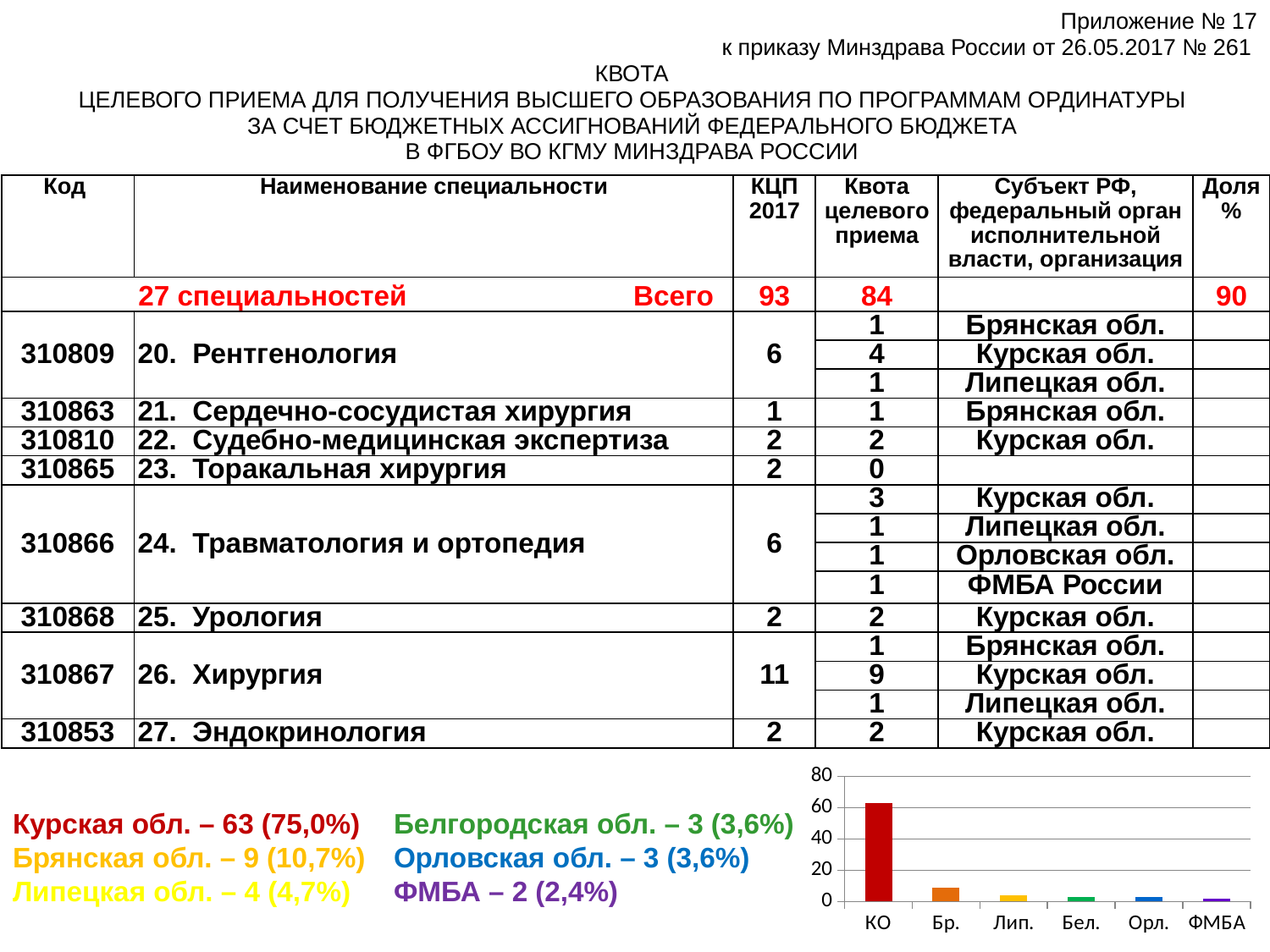
Do the bar values rise or fall from left to right along the x axis? fall Is the value for Бр. greater or less than 20? less How many categories are shown on the x axis of the bar chart? 6 Is the value for КО greater or less than 40? greater Which category has the highest bar in the chart? КО Is the value for КО greater or less than 80? less What kind of chart is shown at the bottom right of the slide? bar chart What colour is the bar for КО? red Which is larger, the bar for Бр. or the bar for Лип.? Бр. What is the highest tick value shown on the y axis of the chart? 80 Which is larger, the bar for КО or the bar for Бр.? КО